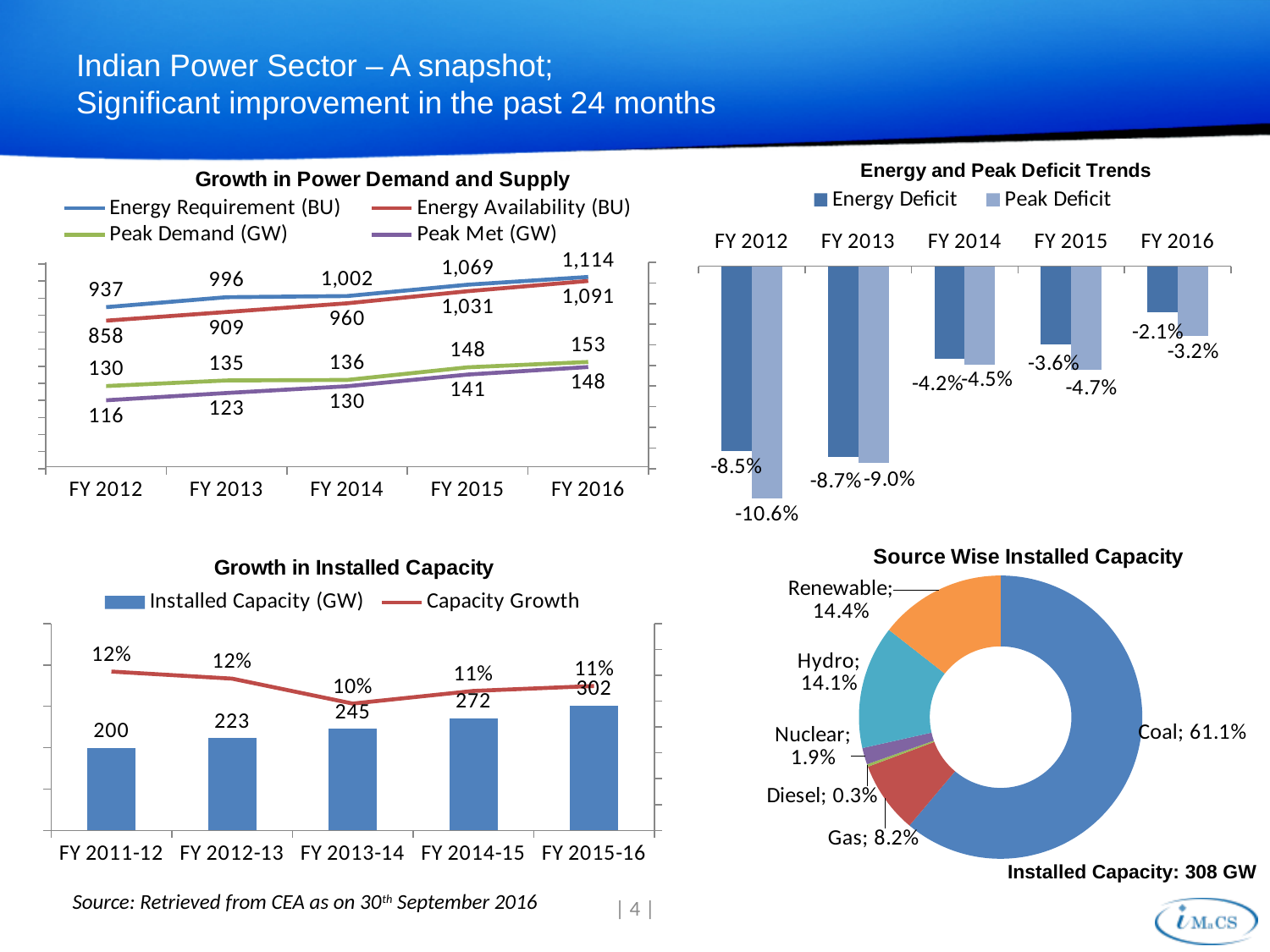
In the 'Growth in Installed Capacity' chart, what is the Installed Capacity (GW) for FY 2015-16? 302 In the 'Source Wise Installed Capacity' chart, which source has the smallest share? Diesel In the 'Growth in Installed Capacity' chart, what is the Capacity Growth for FY 2013-14? 10% In the 'Growth in Installed Capacity' chart, do the Installed Capacity (GW) bars rise or fall from FY 2011-12 to FY 2015-16? rise In the 'Source Wise Installed Capacity' chart, what share does Coal have? 61.1% In the 'Growth in Power Demand and Supply' chart, what is the Energy Requirement (BU) value for FY 2016? 1,114 In the 'Growth in Power Demand and Supply' chart, what is the difference between Energy Requirement (BU) and Energy Availability (BU) in FY 2012? 79 In the 'Energy and Peak Deficit Trends' chart, which fiscal year has the smallest Energy Deficit in magnitude? FY 2016 In the 'Energy and Peak Deficit Trends' chart, what is the Energy Deficit for FY 2015? -3.6% In the 'Growth in Power Demand and Supply' chart, what is the Peak Met (GW) value for FY 2014? 130 How many series does the legend of the 'Growth in Power Demand and Supply' chart list? 4 In the 'Energy and Peak Deficit Trends' chart, what is the Peak Deficit for FY 2012? -10.6%